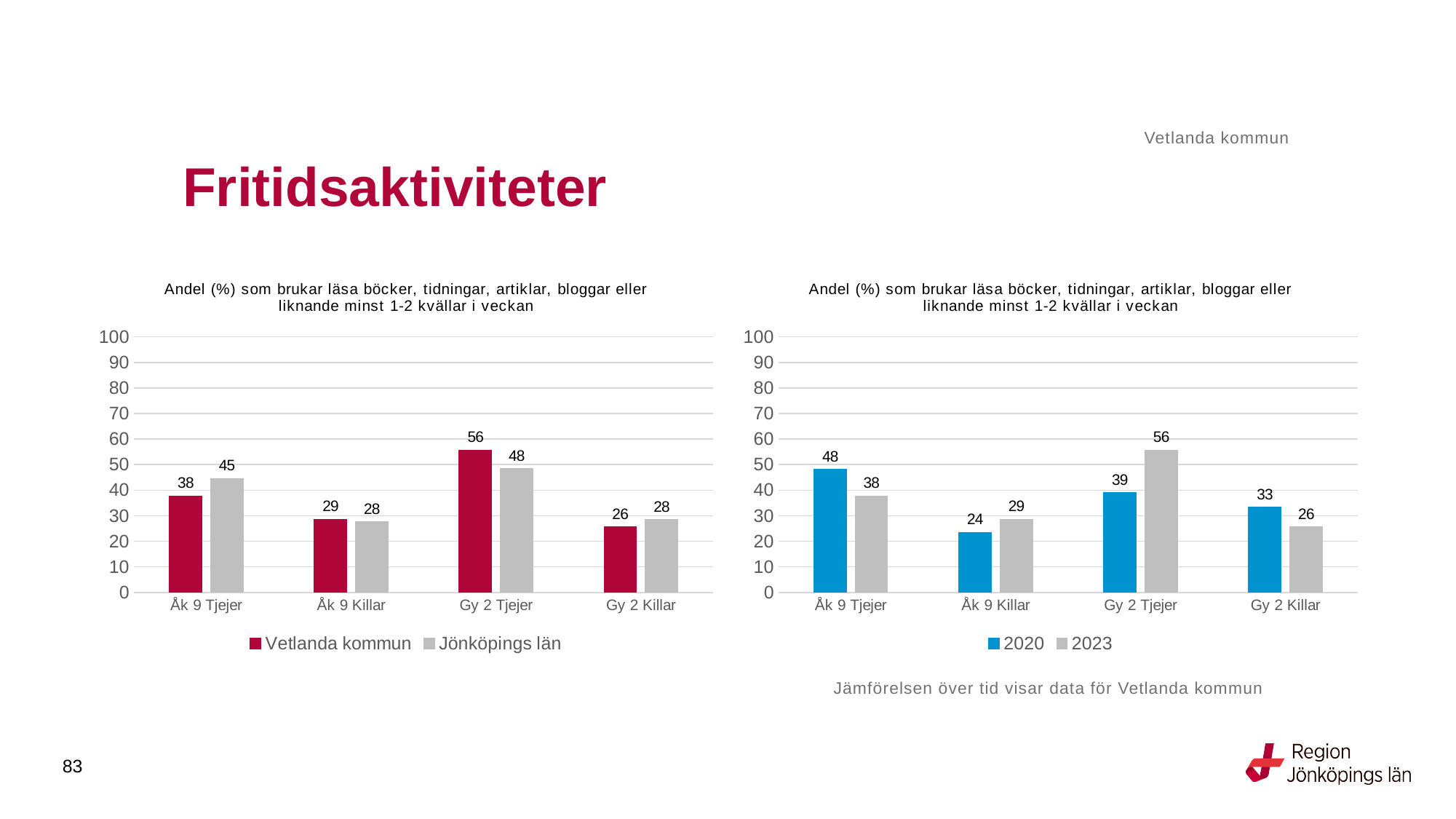
In the left chart, what is the value for Vetlanda kommun for Gy 2 Tjejer? 56 In the right chart, what is the 2023 value for Gy 2 Tjejer? 56 In the left chart, what is the value for Jönköpings län for Åk 9 Tjejer? 45 In the right chart, what is the 2020 value for Åk 9 Killar? 24 In the left chart, which category has the lowest value for Vetlanda kommun? Gy 2 Killar What type of chart is the left chart? Bar chart In the right chart, which category has the highest 2020 value? Åk 9 Tjejer In the right chart, what is the difference between the 2023 and 2020 values for Gy 2 Tjejer? 17 In the left chart, what is the difference between the Vetlanda kommun and Jönköpings län values for Gy 2 Tjejer? 8 In the right chart, which is larger for Gy 2 Killar: the 2020 value or the 2023 value? 2020 How many series does the legend of the right chart list? 2 How many categories are shown on the x axis of the left chart? 4